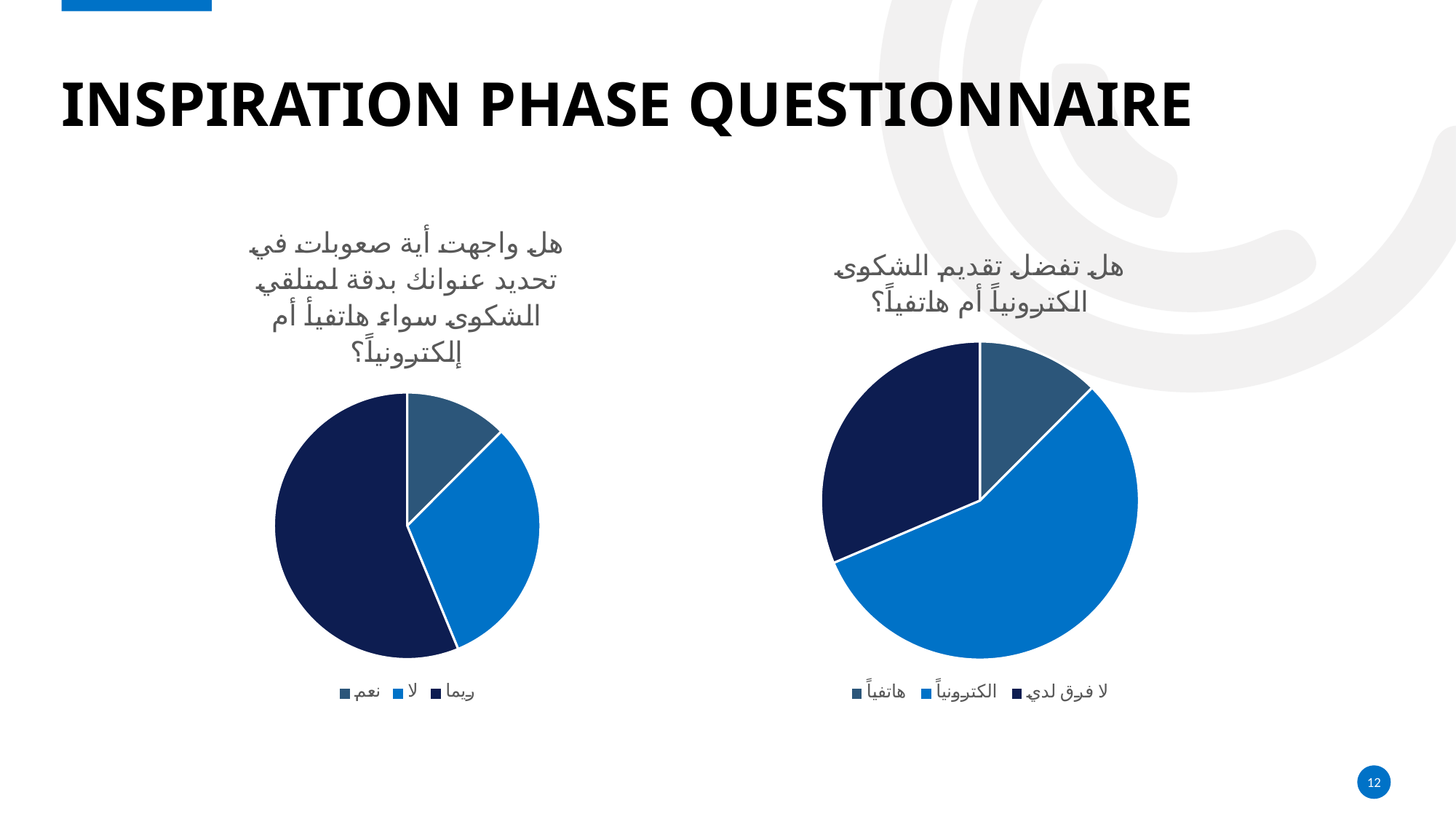
In the right pie chart, is the bright blue slice larger or smaller than the dark navy slice? larger How many entries does the legend of the right pie chart list? 3 How many entries does the legend of the left pie chart list? 3 How many slices does the left pie chart have? 3 In the left pie chart, which colour slice is the smallest? dark slate blue In the right pie chart, which colour slice is the smallest? dark slate blue In the left pie chart, which colour slice is the largest? dark navy In the right pie chart, which colour slice is the largest? bright blue How many slices does the right pie chart have? 3 What kind of chart is the right chart on the slide? pie chart What kind of chart is the left chart on the slide? pie chart How many pie charts are shown on the slide? 2